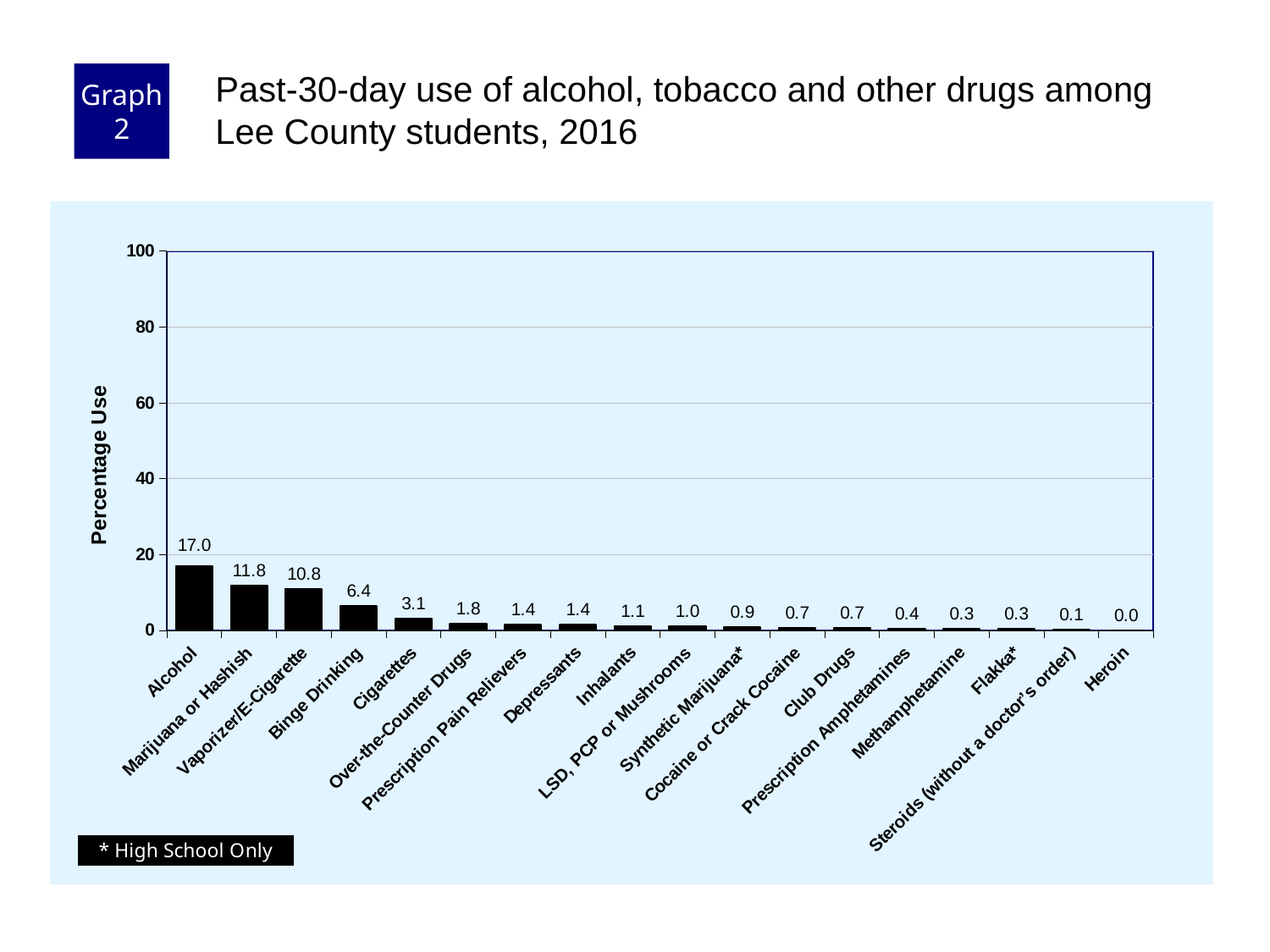
Which category has the highest percentage use? Alcohol What is the difference in percentage use between Alcohol and Marijuana or Hashish? 5.2 What is the percentage use for Cigarettes? 3.1 What is the percentage use for Heroin? 0.0 What kind of chart is shown on the slide? Bar chart What is the percentage use for Vaporizer/E-Cigarette? 10.8 How many categories are shown on the x axis? 18 What is the label of the y axis? Percentage Use Is the value for Alcohol greater or less than 20? less Which has a higher percentage use, Binge Drinking or Cigarettes? Binge Drinking What is the percentage use for Alcohol? 17.0 Which category has the lowest percentage use? Heroin